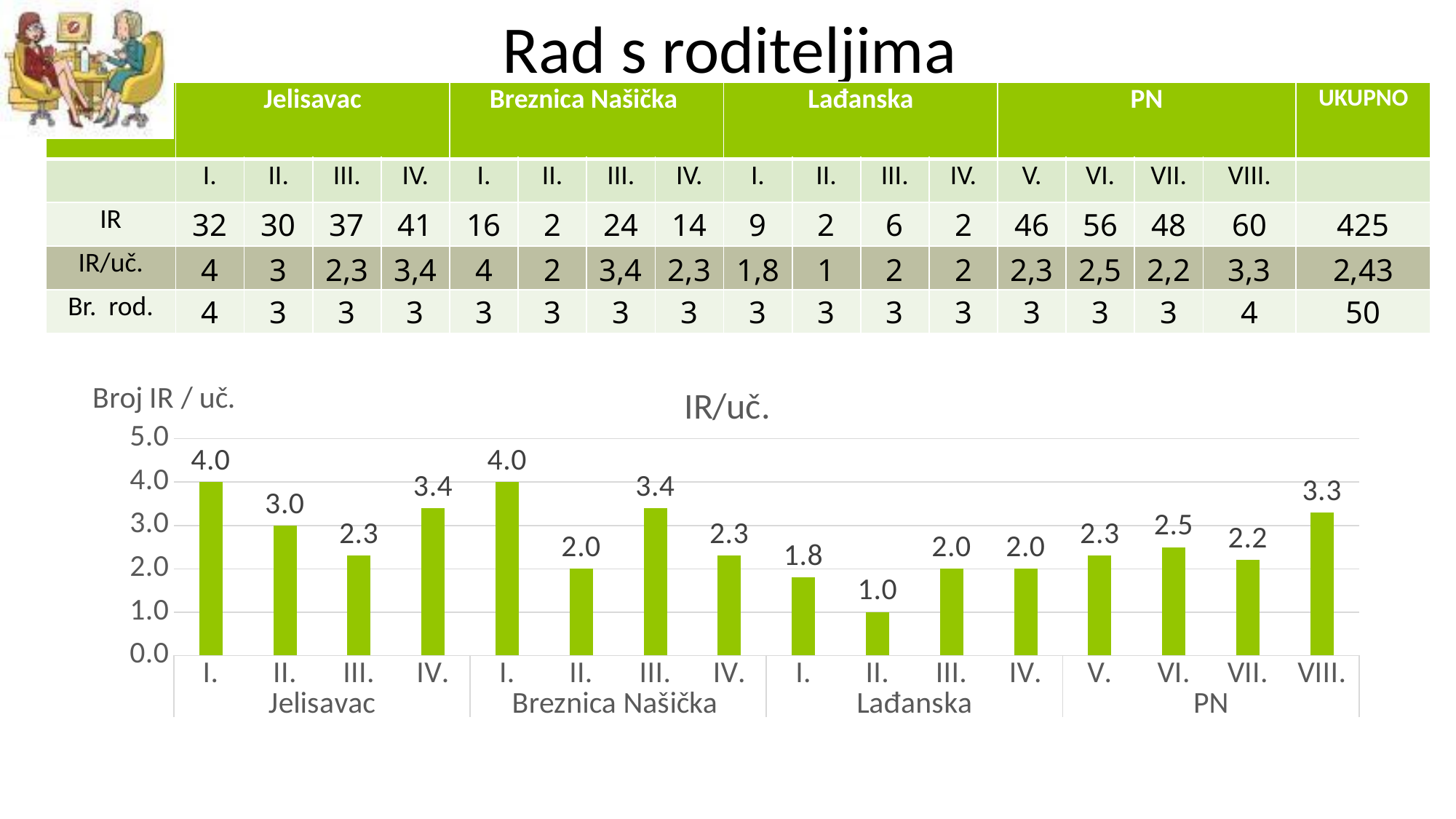
What is the IR/uč. value for class VIII. in PN? 3.3 Which bar has the lowest IR/uč. value? II. in Lađanska What is the difference between the IR/uč. values for class I. and class III. in Jelisavac? 1.7 Is the IR/uč. value for class I. in Lađanska greater or less than 2.0? less What is the IR/uč. value for class IV. in Jelisavac? 3.4 What is the IR/uč. value for class III. in Breznica Našička? 3.4 Which is larger, the IR/uč. value for class VI. in PN or class VII. in PN? VI. in PN What is the IR/uč. value for class II. in Lađanska? 1.0 How many bars are plotted in the chart? 16 Do the IR/uč. values rise or fall from class V. to class VI. in PN? rise What is the title of the chart? IR/uč. What type of chart is shown on the slide? bar chart